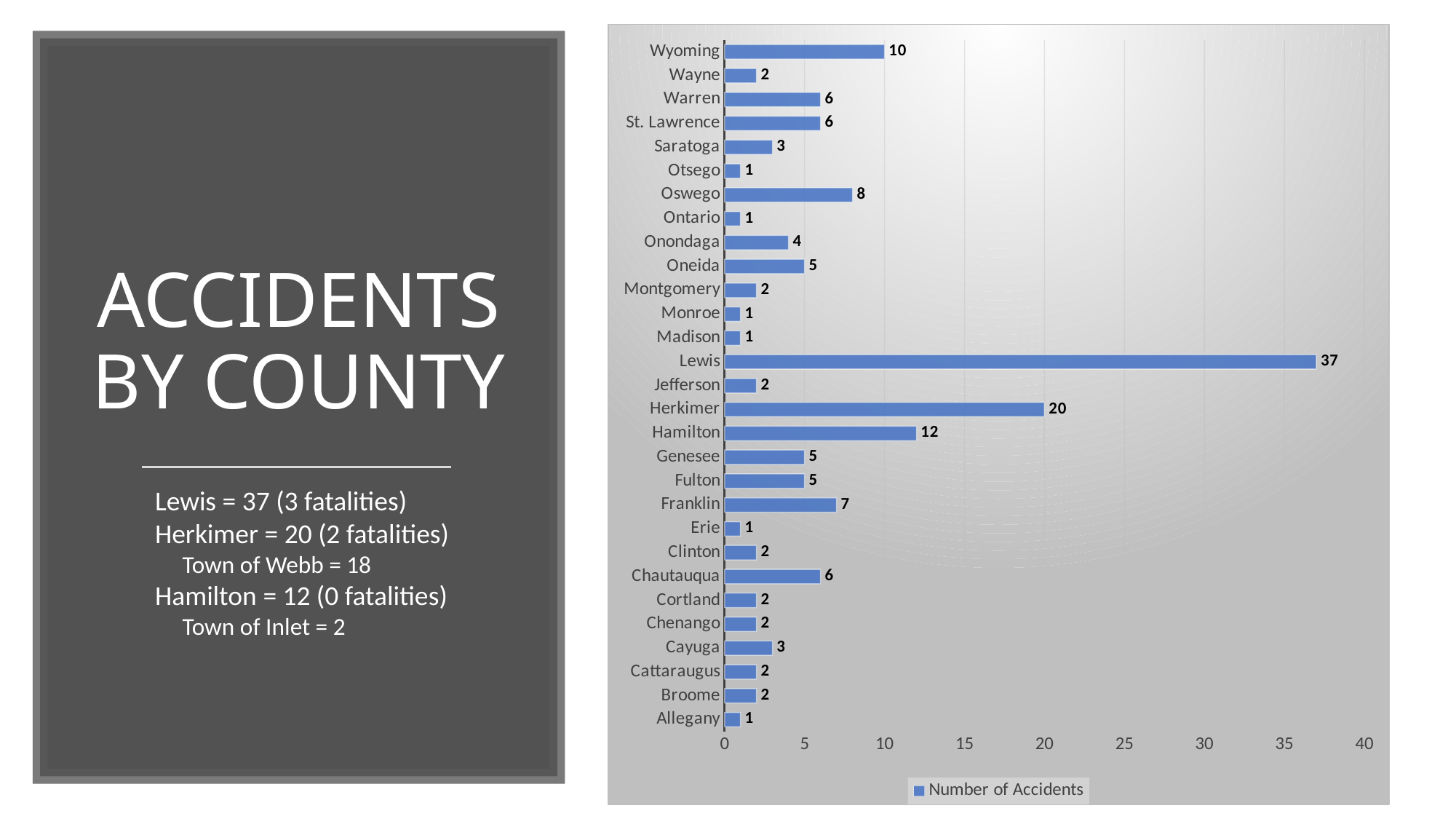
What is the difference in number of accidents between Hamilton and Franklin? 5 What is the number of accidents for Wyoming? 10 What is the number of accidents for Oswego? 8 How many counties are shown in the chart? 29 What series name is listed in the chart legend? Number of Accidents Is the value for Herkimer greater or less than 15? greater Which has more accidents, Chautauqua or Saratoga? Chautauqua What is the number of accidents for Lewis? 37 What is the difference in number of accidents between Lewis and Herkimer? 17 What is the number of accidents for Herkimer? 20 What type of chart is shown on the slide? bar chart Which county has the highest number of accidents? Lewis